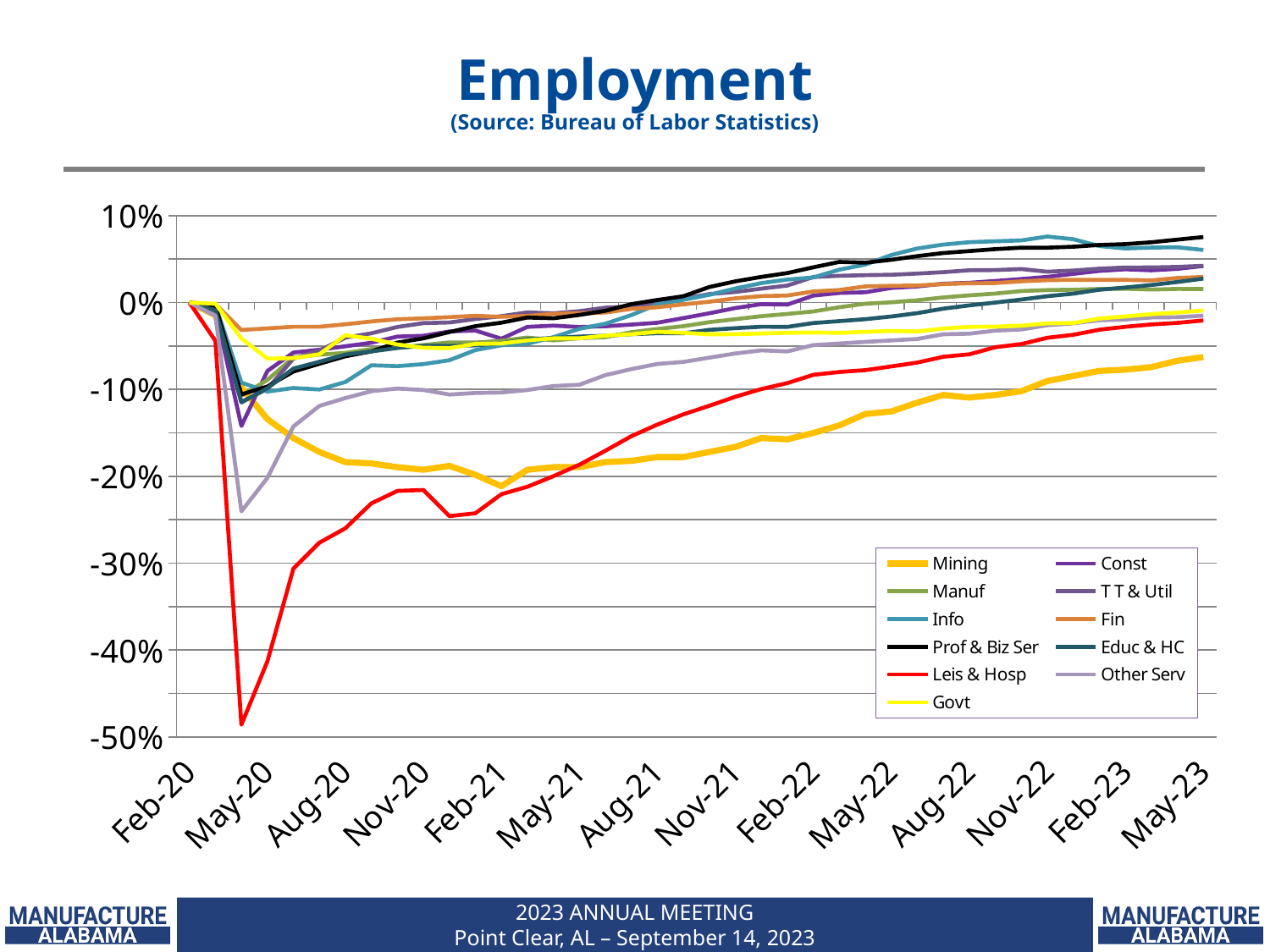
Which series has the lowest value at May-23? Mining Is the value for Mining at May-23 greater or less than 0%? less Does the Mining series rise or fall from Aug-20 to May-23? rise Which series drops to the lowest value on the chart? Leis & Hosp Is the lowest value for Leis & Hosp greater or less than -40%? less Is the value for Prof & Biz Ser at May-23 greater or less than 5%? greater How many series does the legend list? 11 What source is cited for the chart data? Bureau of Labor Statistics What kind of chart is shown on the slide? line chart What is the title of the chart? Employment How many month labels are shown on the x axis? 14